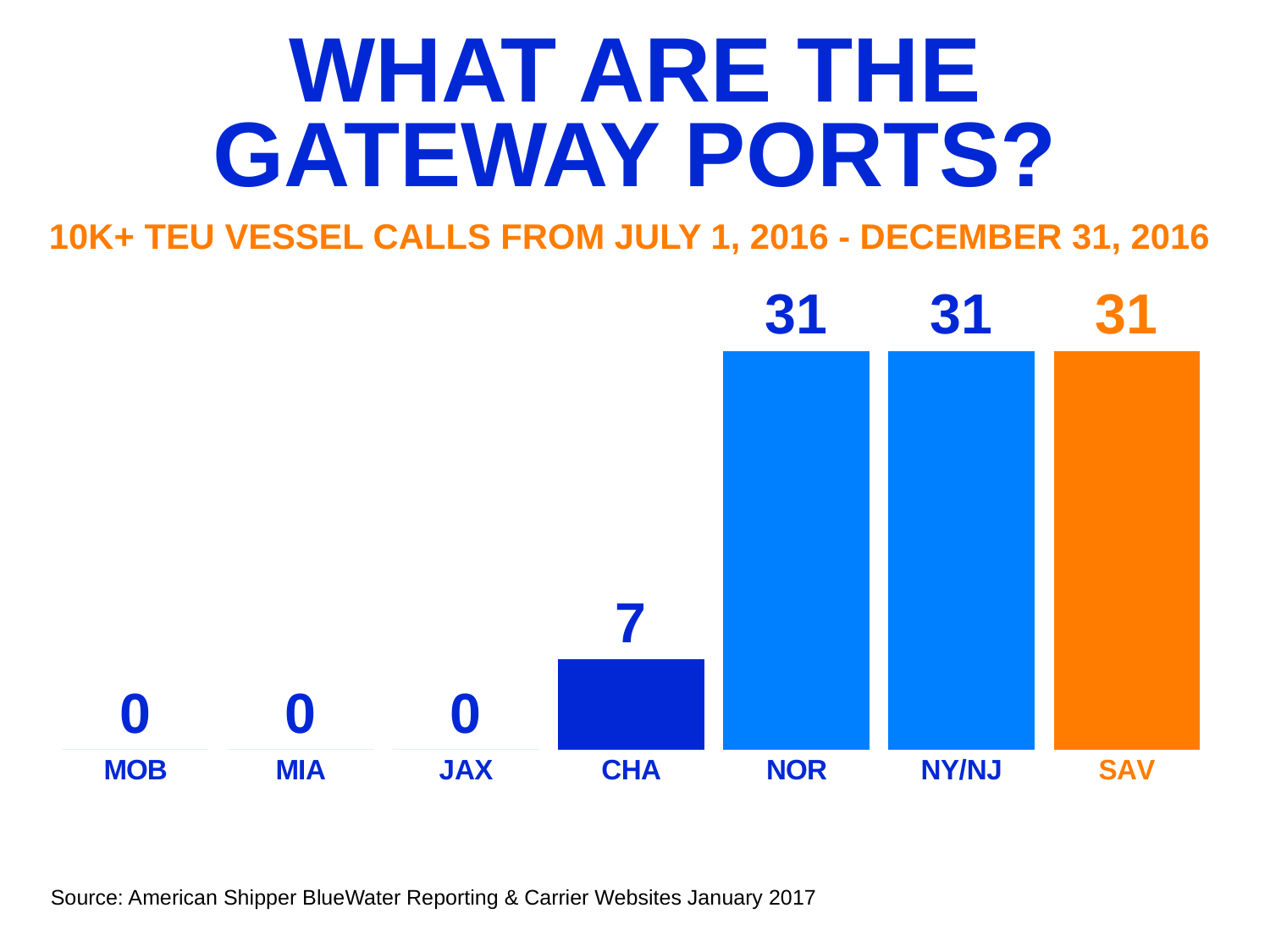
What kind of chart is shown on the slide? bar chart How many ports have a value of 31? 3 What is the value for MOB? 0 What is the difference between the values for NOR and CHA? 24 Which category has the lowest value other than the ports with 0? CHA What is the subtitle of the chart? 10K+ TEU VESSEL CALLS FROM JULY 1, 2016 - DECEMBER 31, 2016 What is the value for SAV? 31 Do the values generally rise or fall from left to right along the x axis? rise What is the value for NY/NJ? 31 What is the value for CHA? 7 How many categories are shown on the x axis? 7 Which is larger, the value for CHA or the value for JAX? CHA